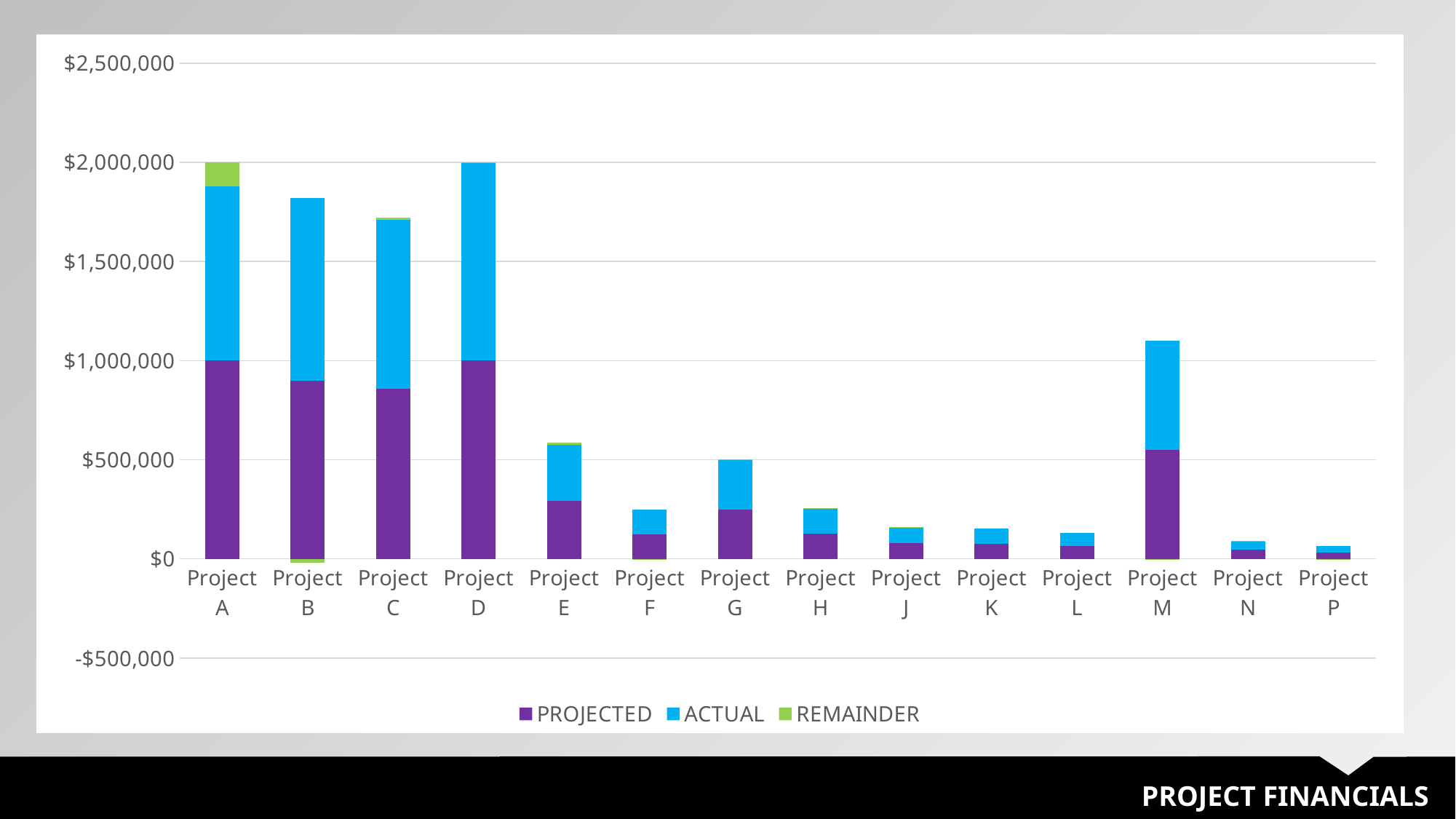
Is the PROJECTED value for Project C greater or less than $1,000,000? less What is the title shown at the bottom of the slide? PROJECT FINANCIALS Which project has the lowest total bar? Project P How many projects are shown on the x axis of the chart? 14 Is the total bar for Project M greater or less than $1,000,000? greater What kind of chart is shown on the slide? Stacked bar chart Which has the larger total bar, Project G or Project M? Project M Which colour represents the ACTUAL series in the chart? Blue How many series does the chart's legend list? 3 Is the total bar for Project F greater or less than $500,000? less Which has the larger total bar, Project B or Project C? Project B